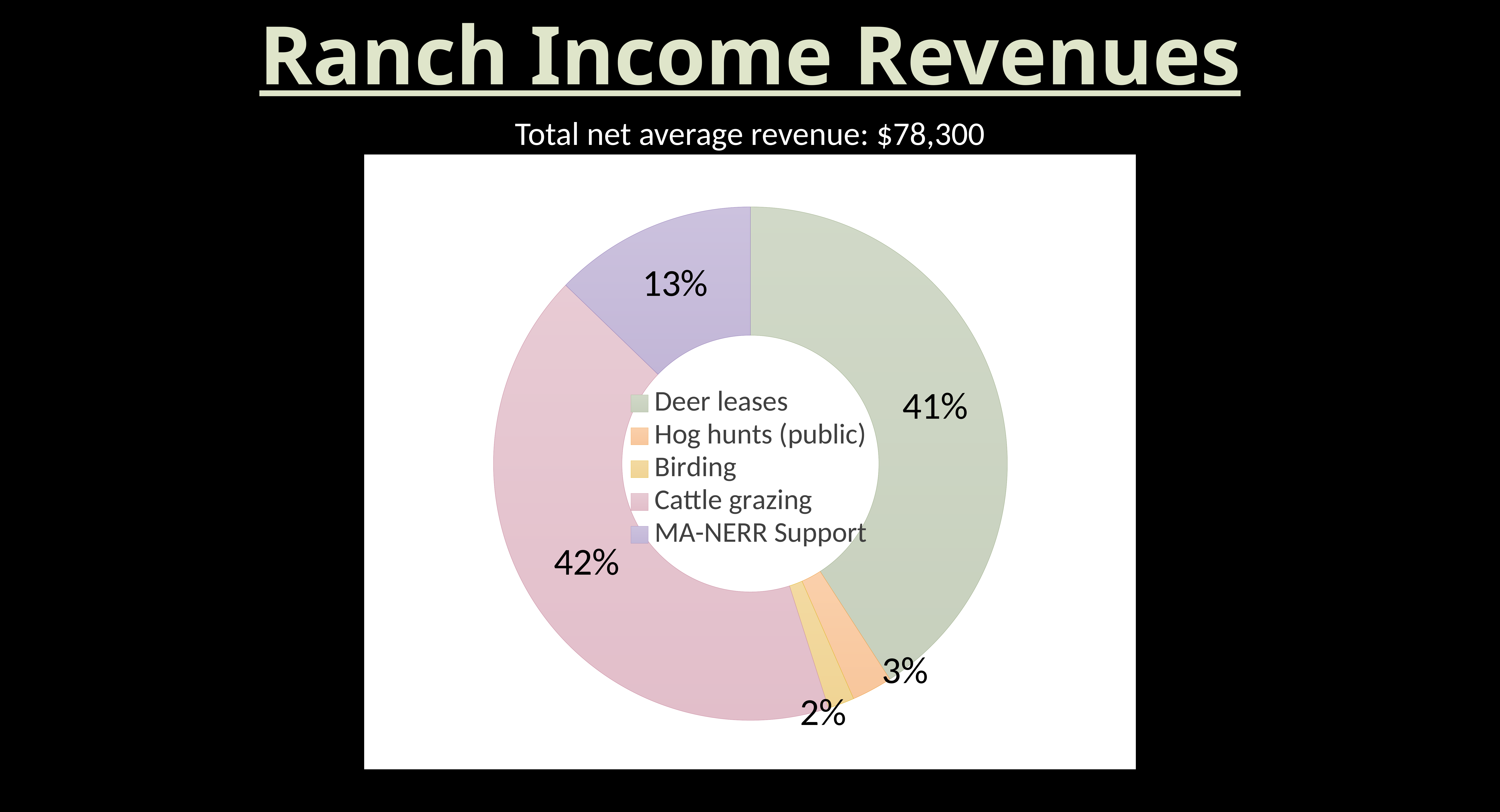
Which revenue source has the largest share of the chart? Cattle grazing What is the difference in percentage points between the Cattle grazing share and the MA-NERR Support share? 29 What total net average revenue is stated above the chart? $78,300 What share of ranch income revenues comes from MA-NERR Support? 13% How many revenue categories are shown in the chart? 5 What share of ranch income revenues comes from Cattle grazing? 42% What share of ranch income revenues comes from Hog hunts (public)? 3% Which revenue source has the smallest share of the chart? Birding What kind of chart is shown on the slide? doughnut chart What share of ranch income revenues comes from Birding? 2% Which is larger, the share for Hog hunts (public) or the share for Birding? Hog hunts (public) What share of ranch income revenues comes from Deer leases? 41%